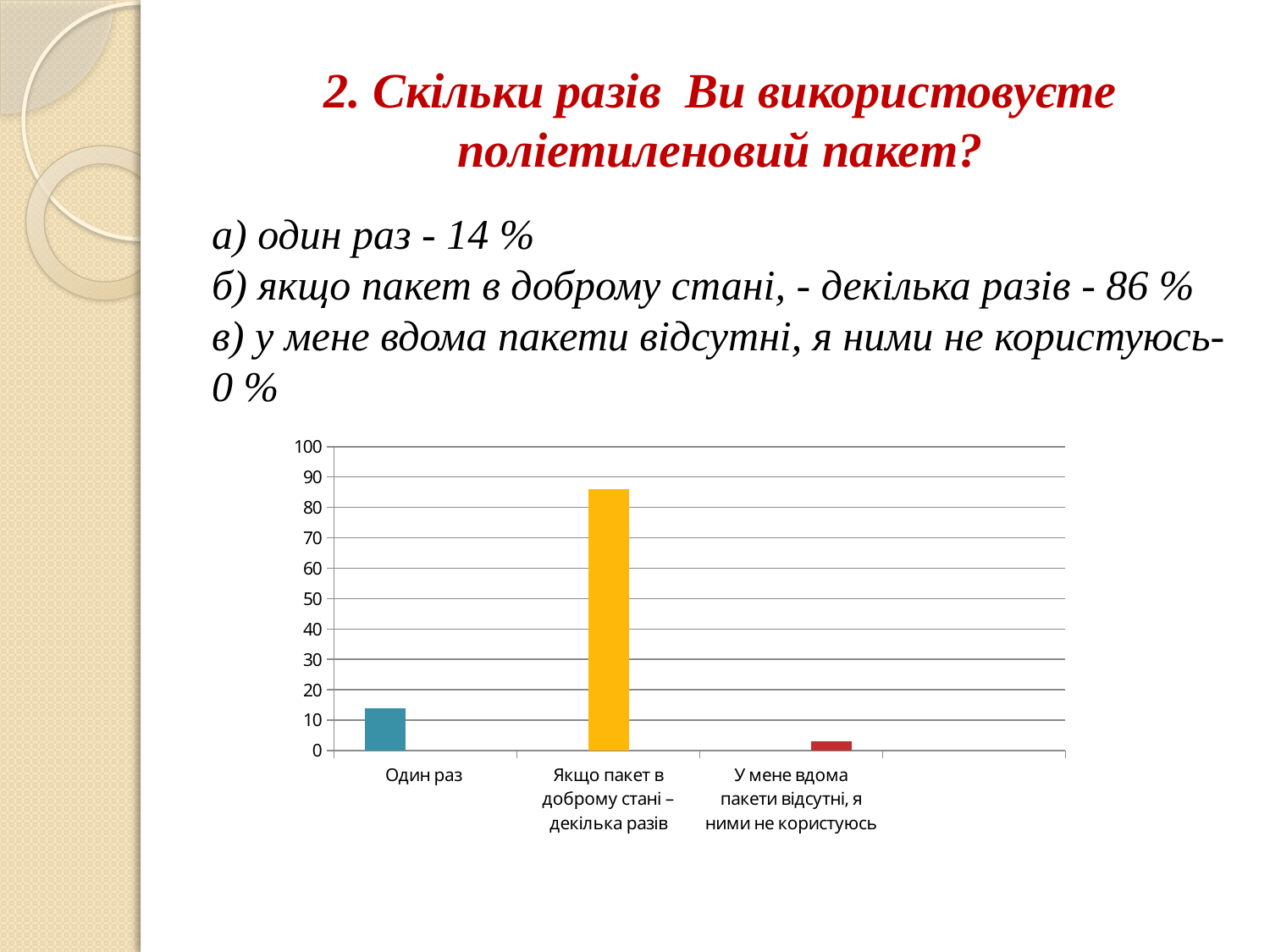
Is the value for "Один раз" greater or less than 20? less Is the value for "Один раз" greater or less than 10? greater Is the value for "Якщо пакет в доброму стані – декілька разів" greater or less than 90? less What is the highest value shown on the chart's vertical axis? 100 Which category has the lowest bar in the chart? У мене вдома пакети відсутні, я ними не користуюсь Which bar is taller: "Один раз" or "Якщо пакет в доброму стані – декілька разів"? Якщо пакет в доброму стані – декілька разів Which category has the highest bar in the chart? Якщо пакет в доброму стані – декілька разів What kind of chart is shown on the slide? bar chart How many categories are shown on the x axis of the chart? 3 Which bar is taller: "Один раз" or "У мене вдома пакети відсутні, я ними не користуюсь"? Один раз